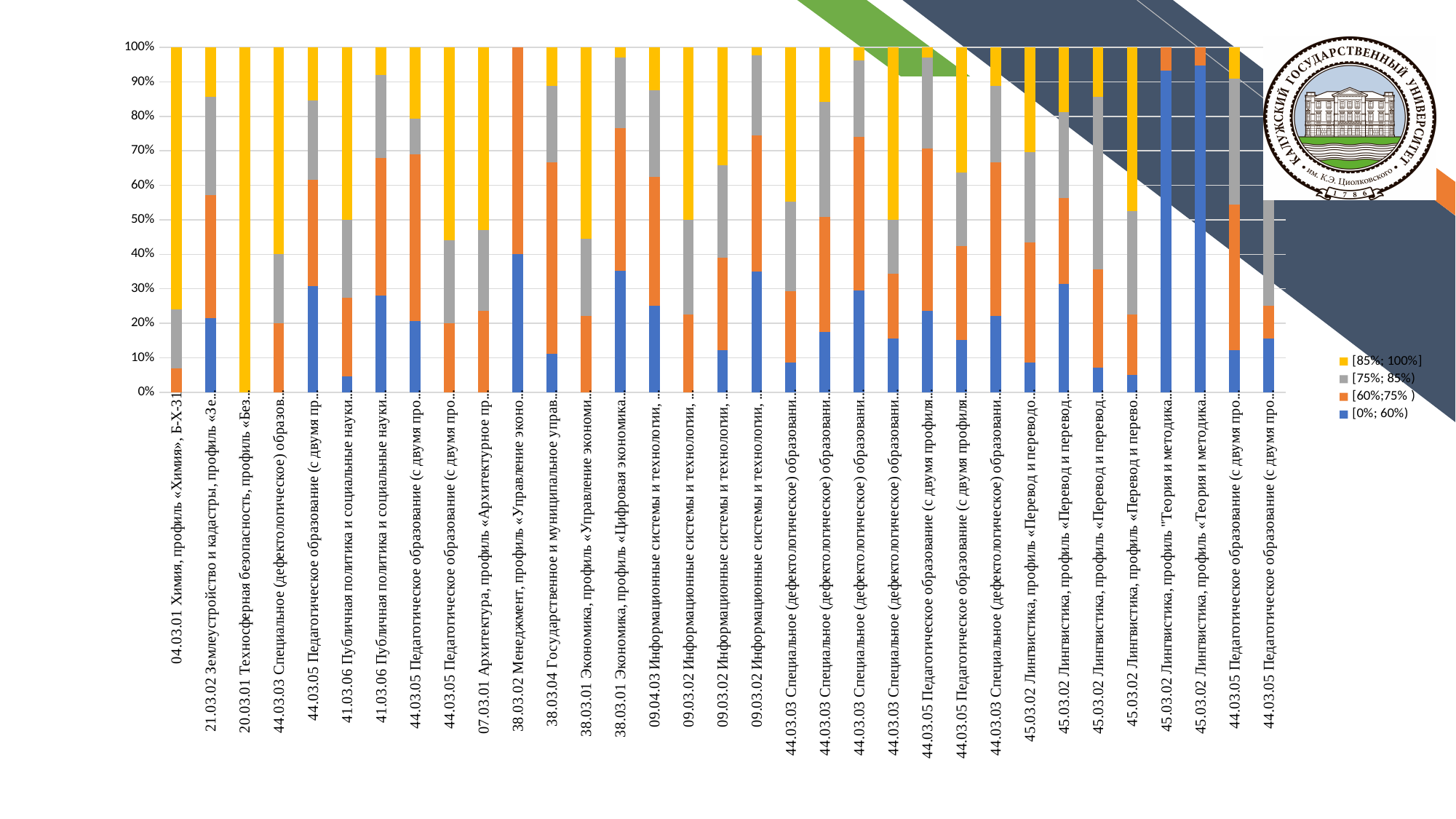
Is the [85%; 100%] share for 04.03.01 Химия, профиль «Химия», Б-Х-31 greater or less than 70%? greater Which has the larger [0%; 60%) share: 38.03.02 Менеджмент or 04.03.01 Химия, профиль «Химия», Б-Х-31? 38.03.02 Менеджмент What is the highest value shown on the vertical axis? 100% Which category's bar is made up entirely of the [85%; 100%] series? 20.03.01 Техносферная безопасность Which colour represents the [0%; 60%) series in the legend? Blue Is the [0%; 60%) share for 38.03.01 Экономика, профиль «Цифровая экономика» greater or less than 30%? greater What kind of chart is shown on the slide? Stacked bar chart Which colour represents the [85%; 100%] series in the legend? Yellow How many categories (programmes) are plotted along the x axis? 33 Is the [0%; 60%) share for 38.03.02 Менеджмент, профиль «Управление эконо...» greater or less than 50%? less How many series does the legend list? 4